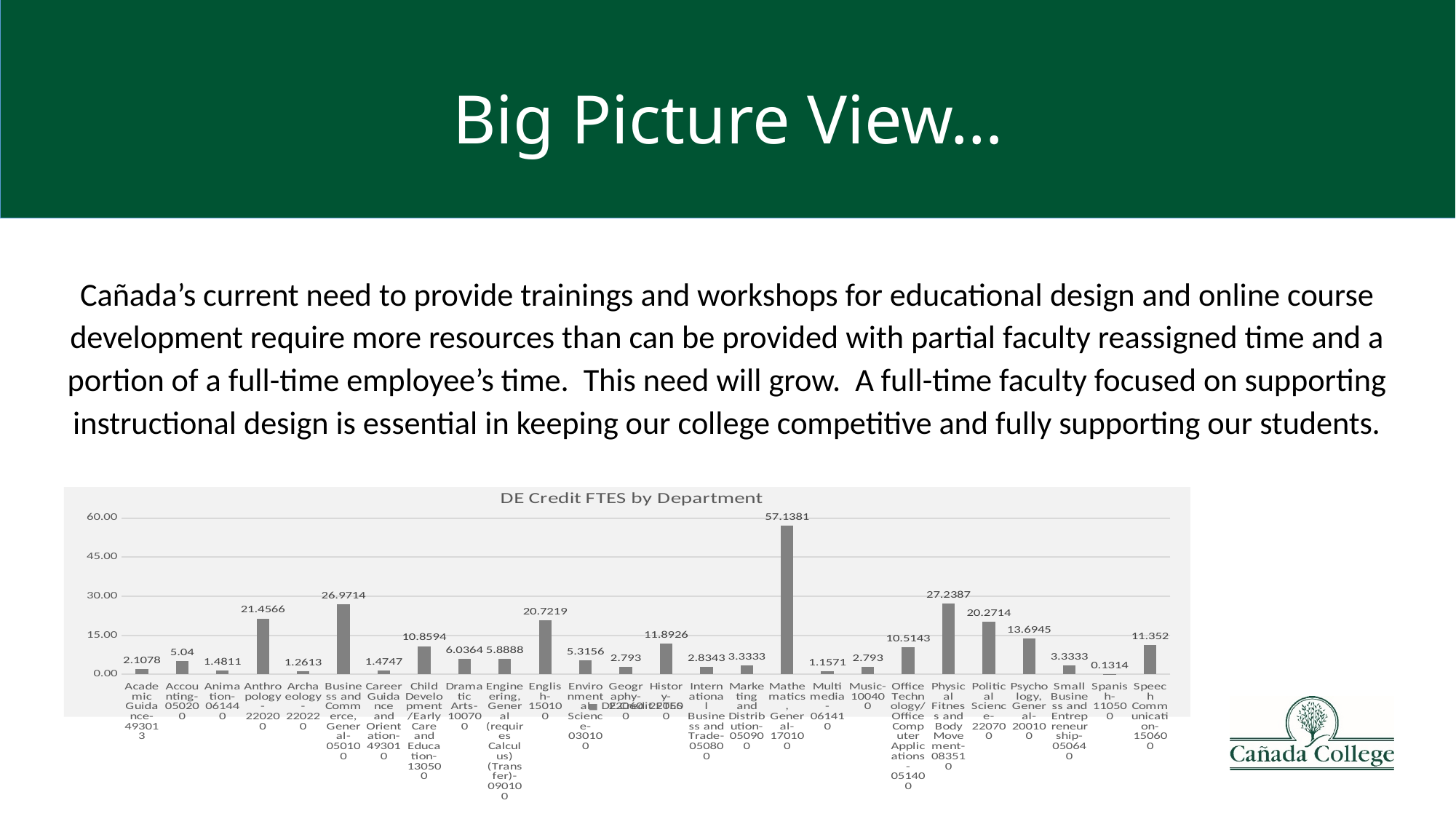
What is the title of the chart on the slide? DE Credit FTES by Department What is the DE Credit FTES value for Mathematics, General-170100? 57.1381 Which department has the lowest DE Credit FTES value in the chart? Spanish-110500 What is the DE Credit FTES value for Spanish-110500? 0.1314 What kind of chart is shown on the slide? bar chart Which is larger, the DE Credit FTES value for Business and Commerce, General-050100 or for English-150100? Business and Commerce, General-050100 Is the DE Credit FTES value for History-220500 greater or less than 15.00? less How many departments are shown in the chart? 26 What is the DE Credit FTES value for Anthropology-220200? 21.4566 What is the difference between the DE Credit FTES values for Mathematics, General-170100 and Physical Fitness and Body Movement-083510? 29.8994 Which department has the highest DE Credit FTES value in the chart? Mathematics, General-170100 What is the DE Credit FTES value for Physical Fitness and Body Movement-083510? 27.2387